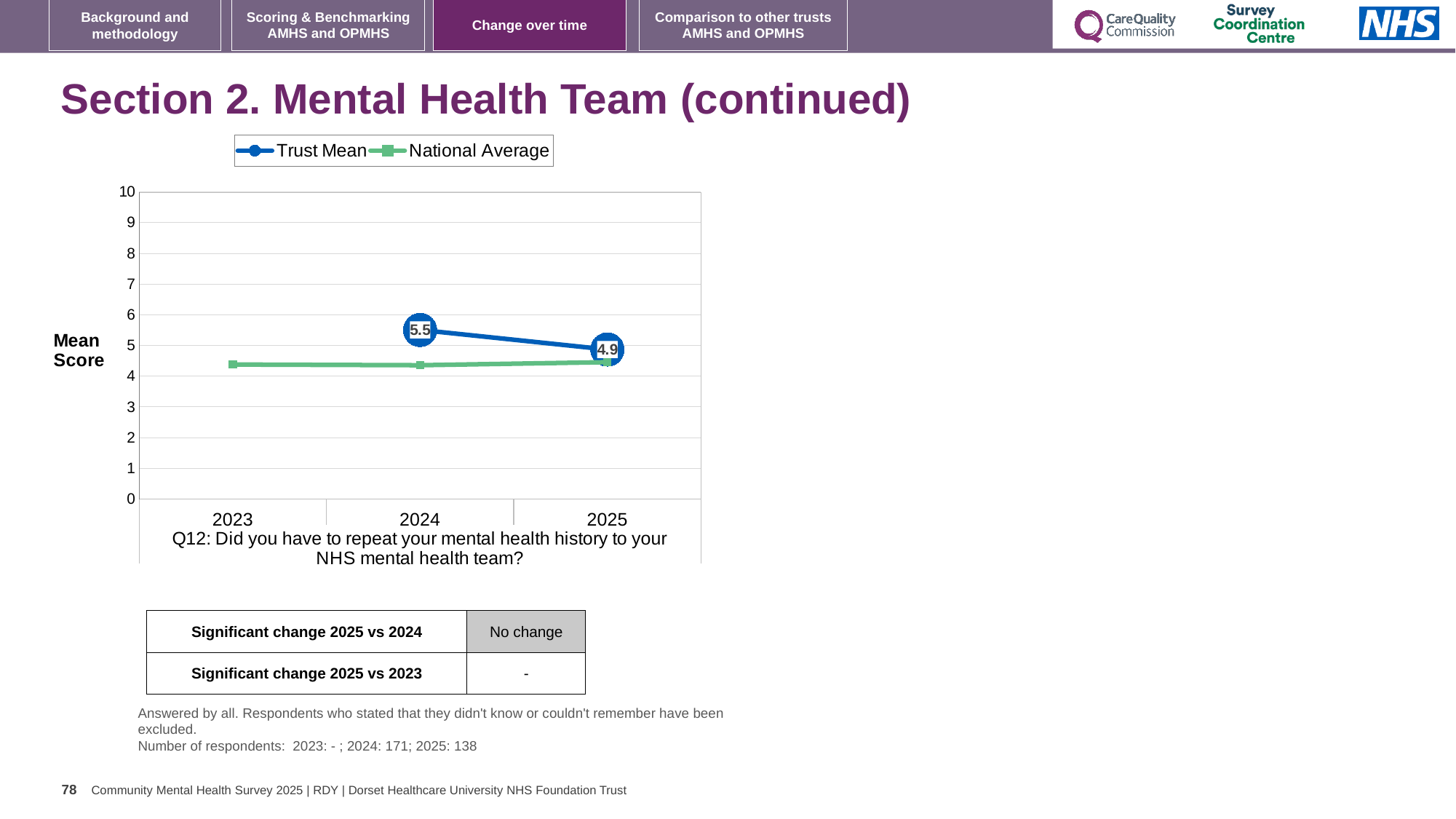
What is the Trust Mean value for 2024? 5.5 What is the difference between the Trust Mean in 2024 and in 2025? 0.6 Is the National Average value for 2023 greater or less than 5? less How many series does the legend list? 2 Does the Trust Mean rise or fall from 2024 to 2025? fall Is the National Average value for 2025 greater or less than 6? less Which year has the higher Trust Mean, 2024 or 2025? 2024 What is the Trust Mean value for 2025? 4.9 What is the label on the y axis of the chart? Mean Score In 2025, which is higher, the Trust Mean or the National Average? Trust Mean How many years are shown on the x axis? 3 What kind of chart is shown on the slide? line chart